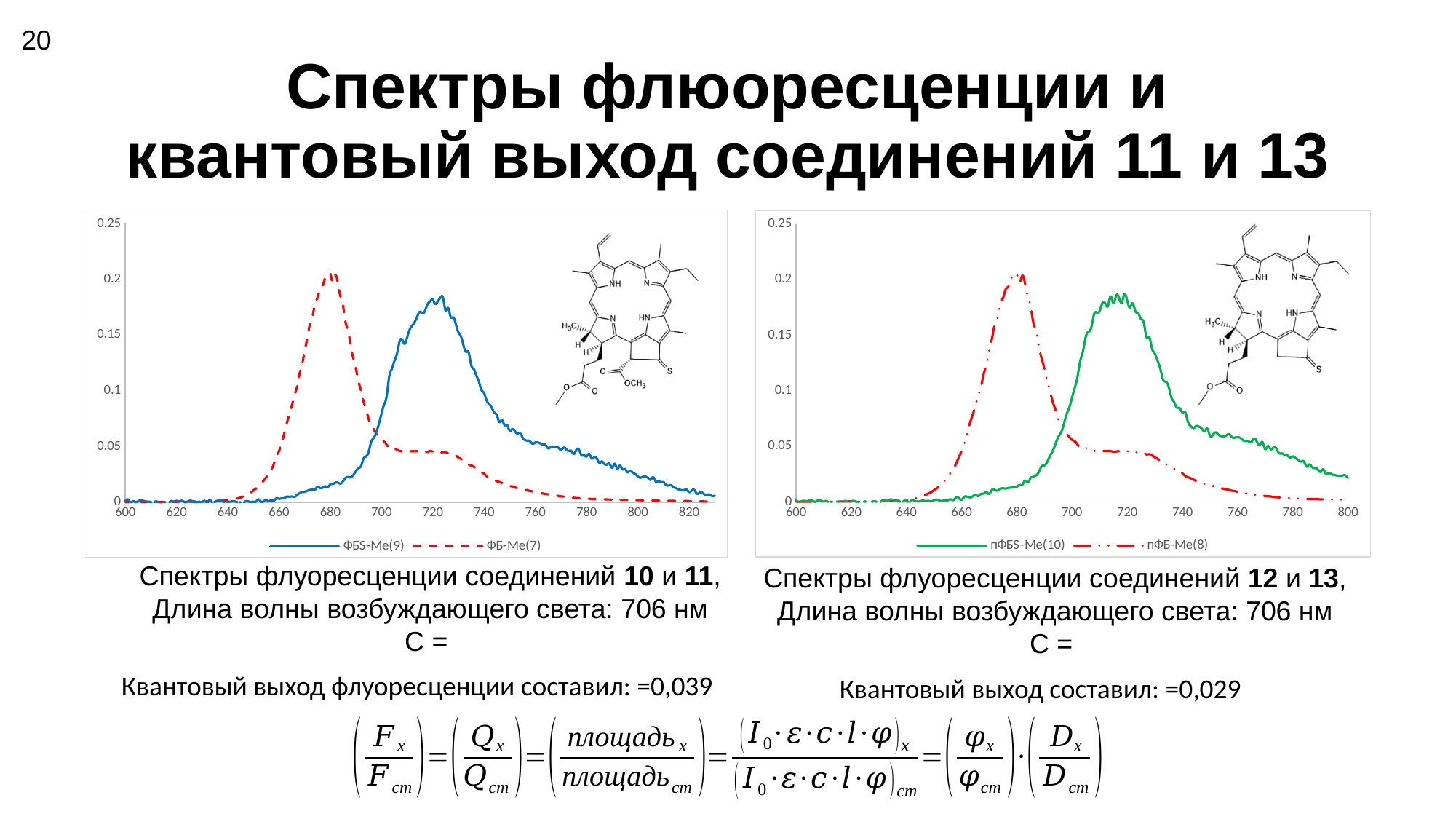
In the right chart, is the peak value of the пФБS-Me(10) series greater or less than 0.1? greater How many series does the legend of the right chart list? 2 In the left chart, is the peak value of the ФБS-Me(9) series greater or less than 0.2? less What kind of chart is the left chart on the slide? line chart In the right chart, is the peak value of the пФБ-Me(8) series greater or less than 0.15? greater What is the maximum value shown on the y axis of the right chart? 0.25 In the left chart, does the ФБS-Me(9) series rise or fall between 740 and 820 on the x axis? fall How many series does the legend of the left chart list? 2 In the right chart, which series reaches its peak at a longer wavelength, пФБS-Me(10) or пФБ-Me(8)? пФБS-Me(10) In the left chart, which series reaches its peak at a shorter wavelength, ФБS-Me(9) or ФБ-Me(7)? ФБ-Me(7) In the right chart, what colour is the line for the пФБS-Me(10) series? green